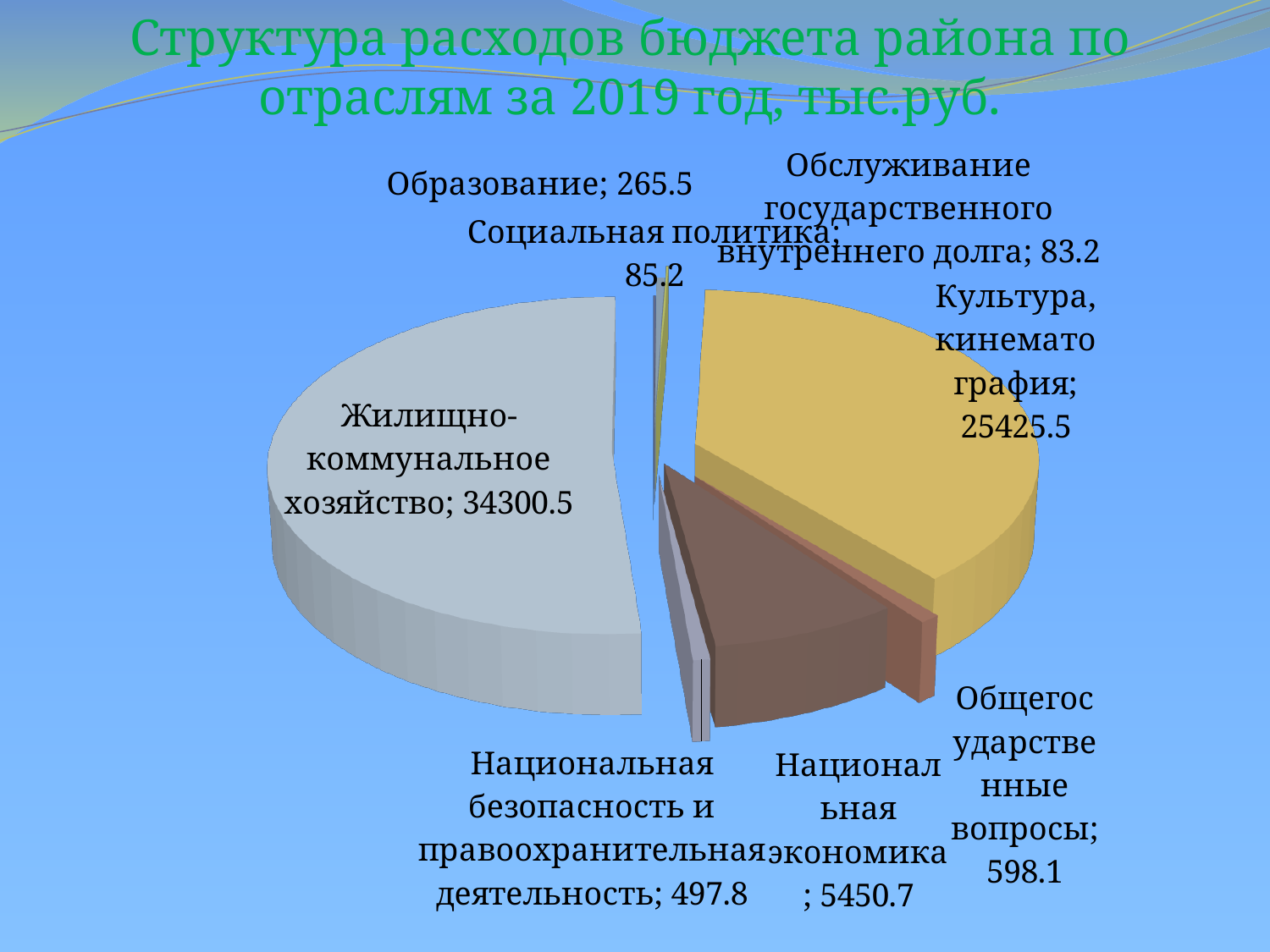
What is the value for Жилищно-коммунальное хозяйство? 34300.5 What is the title of the chart? Структура расходов бюджета района по отраслям за 2019 год, тыс.руб. What is the difference between the values for Жилищно-коммунальное хозяйство and Культура, кинематография? 8875.0 Which category has the largest value? Жилищно-коммунальное хозяйство How many categories does the pie chart show? 8 Which category has the smallest value? Обслуживание государственного внутреннего долга What type of chart is shown on the slide? Pie chart Which is larger: the value for Образование or the value for Социальная политика? Образование What is the value for Культура, кинематография? 25425.5 What is the value for Обслуживание государственного внутреннего долга? 83.2 What is the difference between the values for Общегосударственные вопросы and Национальная безопасность и правоохранительная деятельность? 100.3 What is the value for Национальная экономика? 5450.7